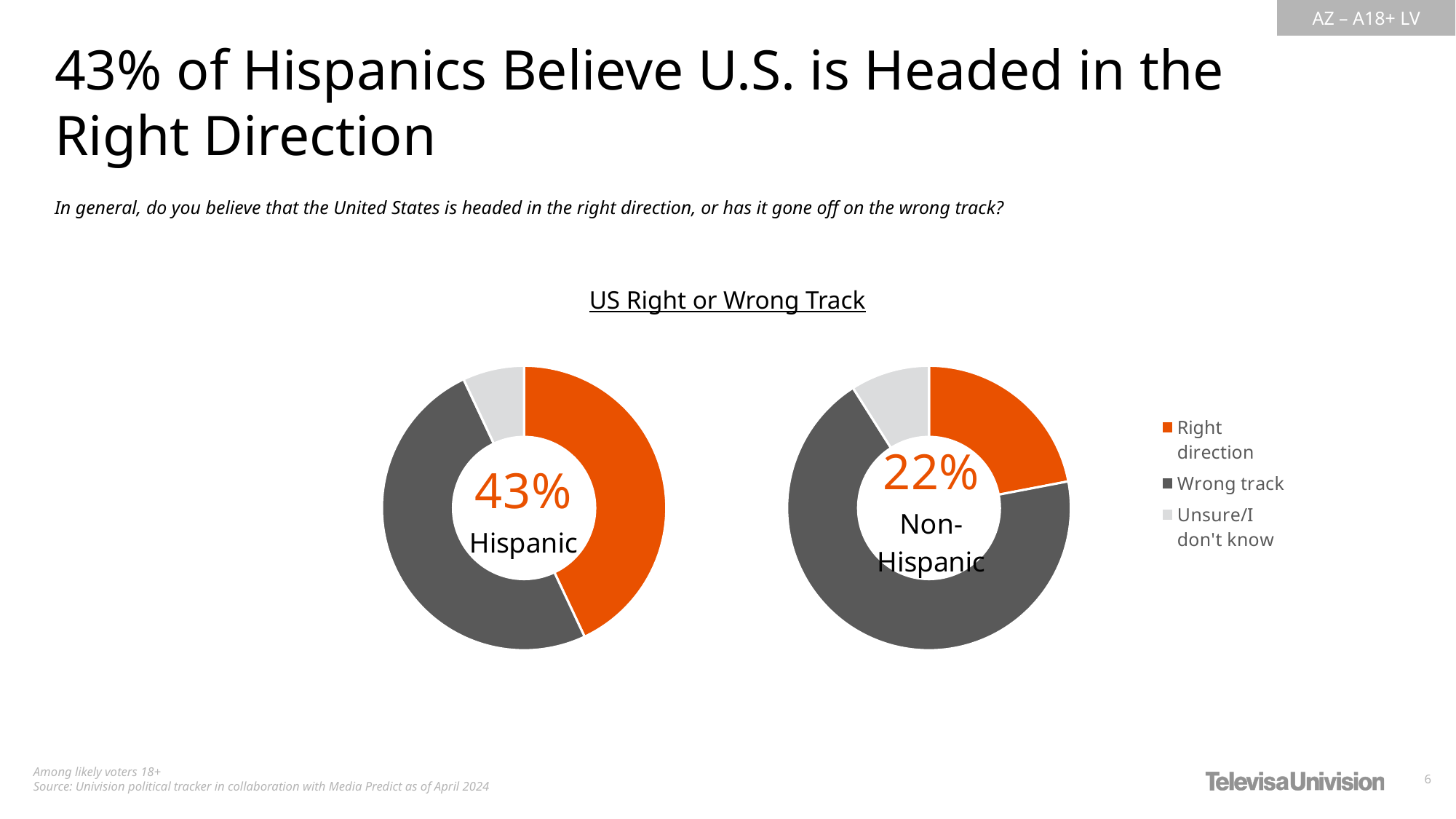
In the Hispanic donut chart, what percentage say the U.S. is headed in the right direction? 43% Which colour represents the 'Right direction' response in the donut charts? Orange How many response categories does the legend list for the US Right or Wrong Track charts? 3 In the Non-Hispanic donut chart, which response category has the smallest slice? Unsure/I don't know In the Non-Hispanic donut chart, what percentage say the U.S. is headed in the right direction? 22% How many donut charts are shown on the slide? 2 In the Hispanic donut chart, which response category has the smallest slice? Unsure/I don't know Which group has the larger share saying the U.S. is headed in the right direction, Hispanic or Non-Hispanic? Hispanic What is the difference in percentage points between the Hispanic and Non-Hispanic shares saying the U.S. is headed in the right direction? 21 percentage points What kind of chart is used to show the US Right or Wrong Track results? Donut (pie) chart What is the title shown above the two donut charts? US Right or Wrong Track In the Non-Hispanic donut chart, which response category has the largest slice? Wrong track